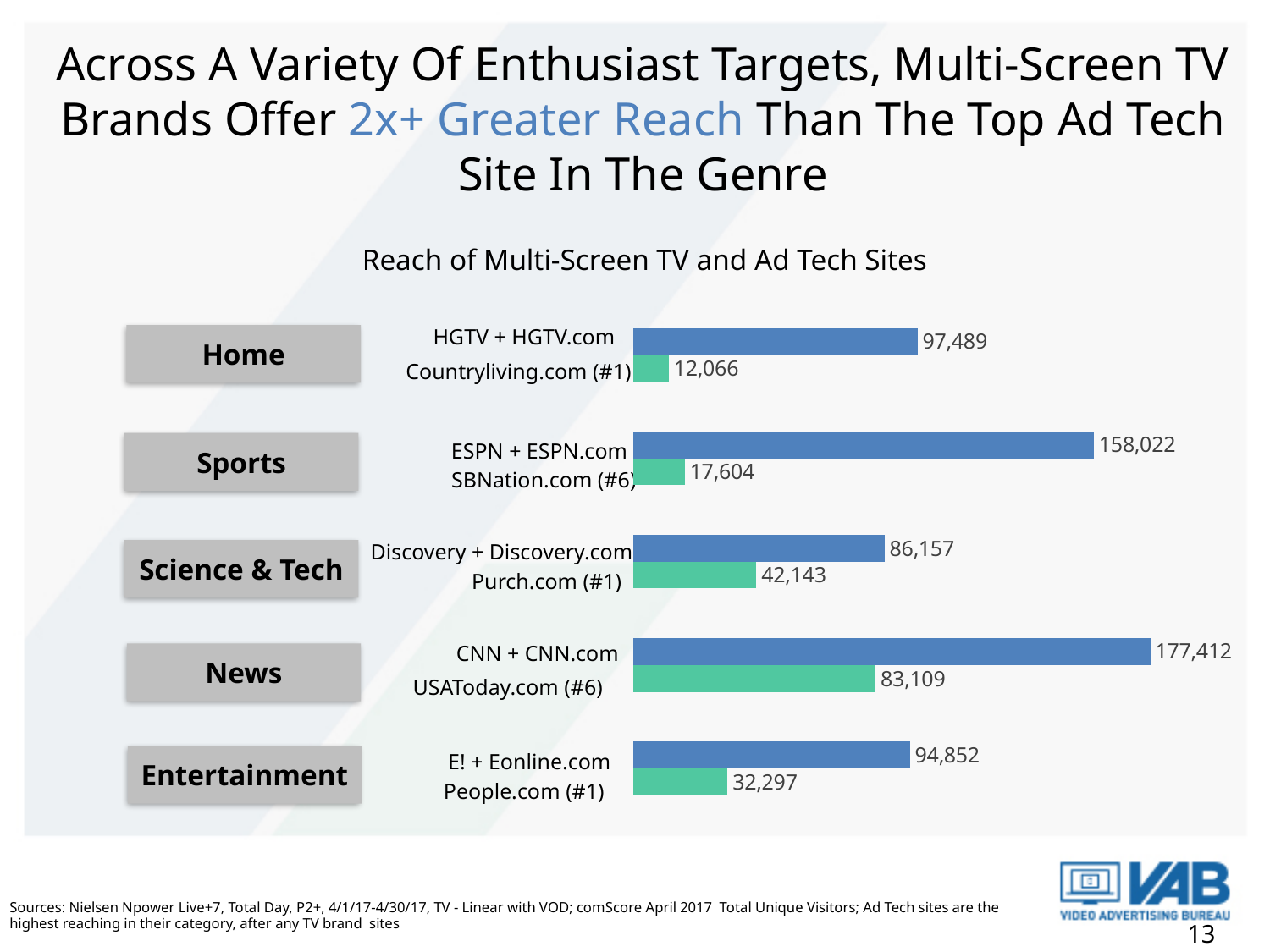
Which bar has the lowest value on the chart? Countryliving.com (#1) What is the difference between the values for CNN + CNN.com and USAToday.com (#6)? 94,303 What is the title of the chart? Reach of Multi-Screen TV and Ad Tech Sites What is the reach value shown for Purch.com (#1)? 42,143 What is the reach value shown for People.com (#1)? 32,297 What kind of chart is shown on the slide? Bar chart What is the reach value shown for SBNation.com (#6)? 17,604 Which bar has the highest value on the chart? CNN + CNN.com What is the difference between the values for ESPN + ESPN.com and SBNation.com (#6)? 140,418 What is the reach value shown for HGTV + HGTV.com? 97,489 How many bars are plotted on the chart? 10 Which is larger, the value for Discovery + Discovery.com or the value for E! + Eonline.com? E! + Eonline.com